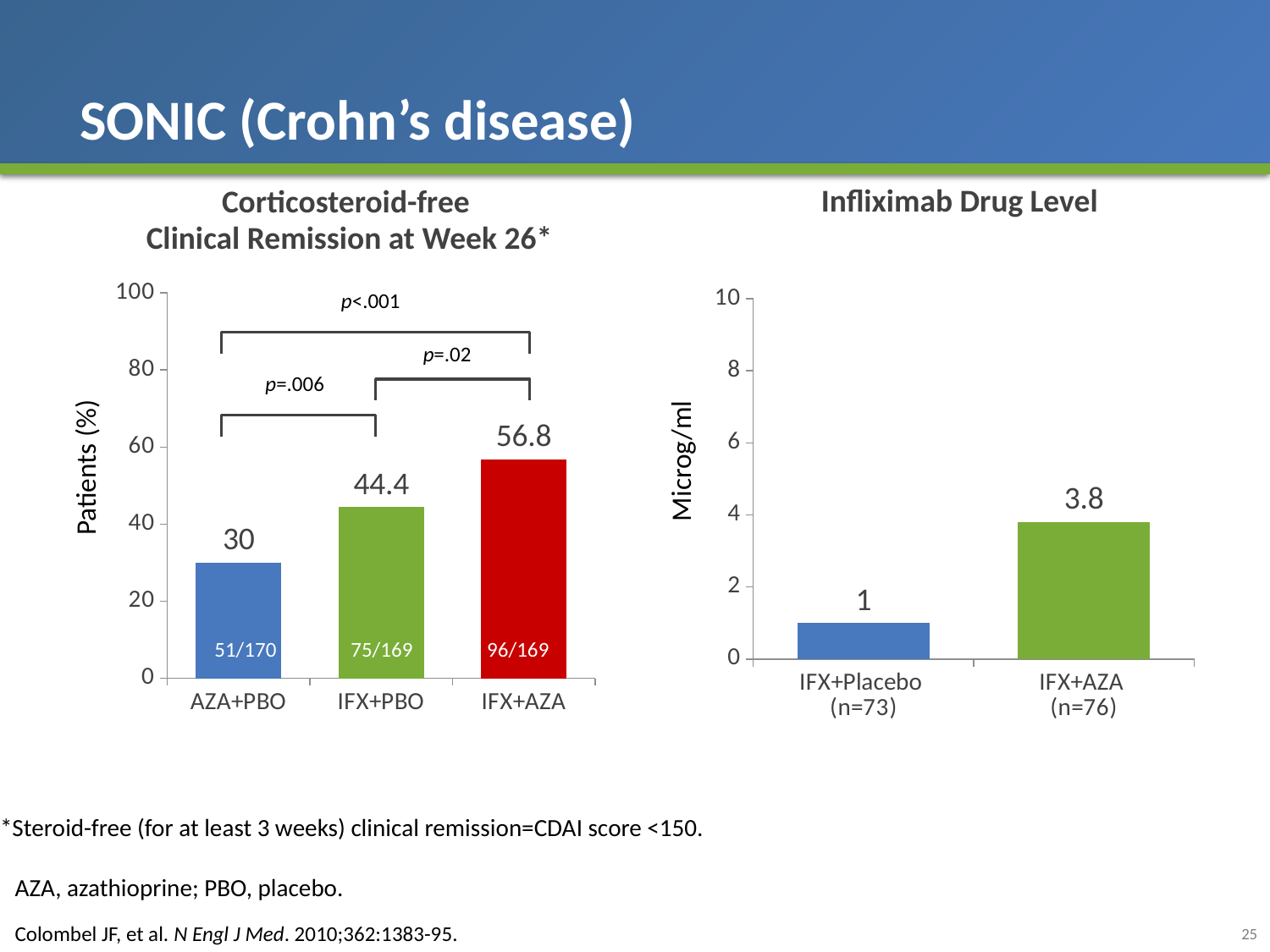
What kind of chart is the Infliximab Drug Level chart? Bar chart In the Infliximab Drug Level chart, what is the value for IFX+Placebo (n=73)? 1 In the Corticosteroid-free Clinical Remission at Week 26 chart, which group has the lowest value? AZA+PBO What is the y-axis label of the Infliximab Drug Level chart? Microg/ml In the Corticosteroid-free Clinical Remission at Week 26 chart, what is the difference between the IFX+AZA and AZA+PBO values? 26.8 In the Corticosteroid-free Clinical Remission at Week 26 chart, what fraction is printed inside the IFX+AZA bar? 96/169 In the Corticosteroid-free Clinical Remission at Week 26 chart, what is the value for IFX+PBO? 44.4 In the Infliximab Drug Level chart, what is the value for IFX+AZA (n=76)? 3.8 In the Infliximab Drug Level chart, what is the difference between the IFX+AZA and IFX+Placebo values? 2.8 In the Corticosteroid-free Clinical Remission at Week 26 chart, what is the value for AZA+PBO? 30 In the Corticosteroid-free Clinical Remission at Week 26 chart, how many groups are shown on the x axis? 3 In the Corticosteroid-free Clinical Remission at Week 26 chart, which group has the highest value? IFX+AZA